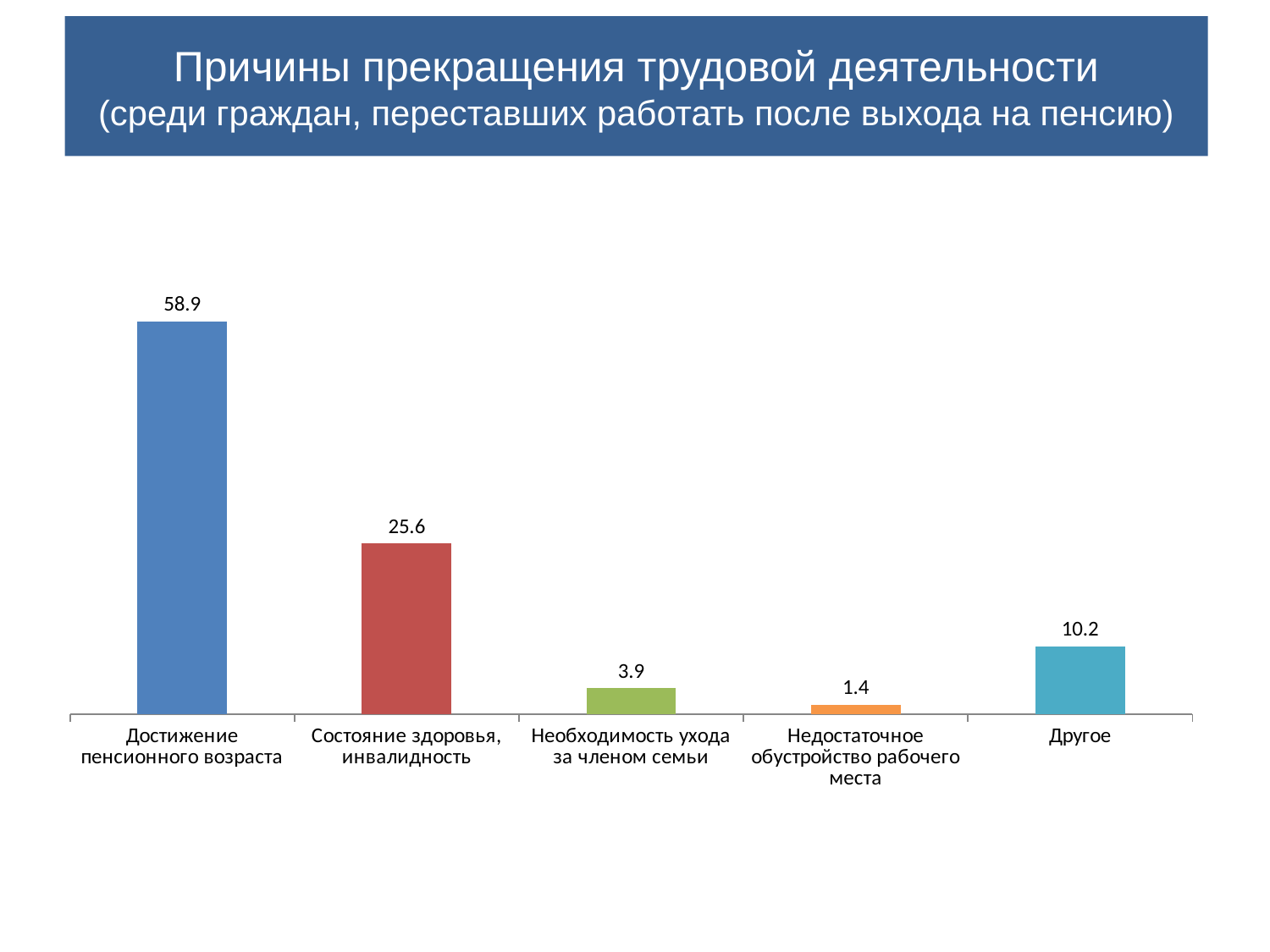
What is the value for «Недостаточное обустройство рабочего места»? 1.4 What is the value for «Другое»? 10.2 Which category has the lowest value? Недостаточное обустройство рабочего места What is the value for «Состояние здоровья, инвалидность»? 25.6 How many categories are shown in the chart? 5 What is the value for «Необходимость ухода за членом семьи»? 3.9 Which is larger: the value for «Другое» or the value for «Необходимость ухода за членом семьи»? Другое What kind of chart is shown on the slide? Bar chart What is the title of the chart? Причины прекращения трудовой деятельности (среди граждан, переставших работать после выхода на пенсию) Which category has the highest value? Достижение пенсионного возраста What is the value for «Достижение пенсионного возраста»? 58.9 What is the difference between the values for «Достижение пенсионного возраста» and «Состояние здоровья, инвалидность»? 33.3